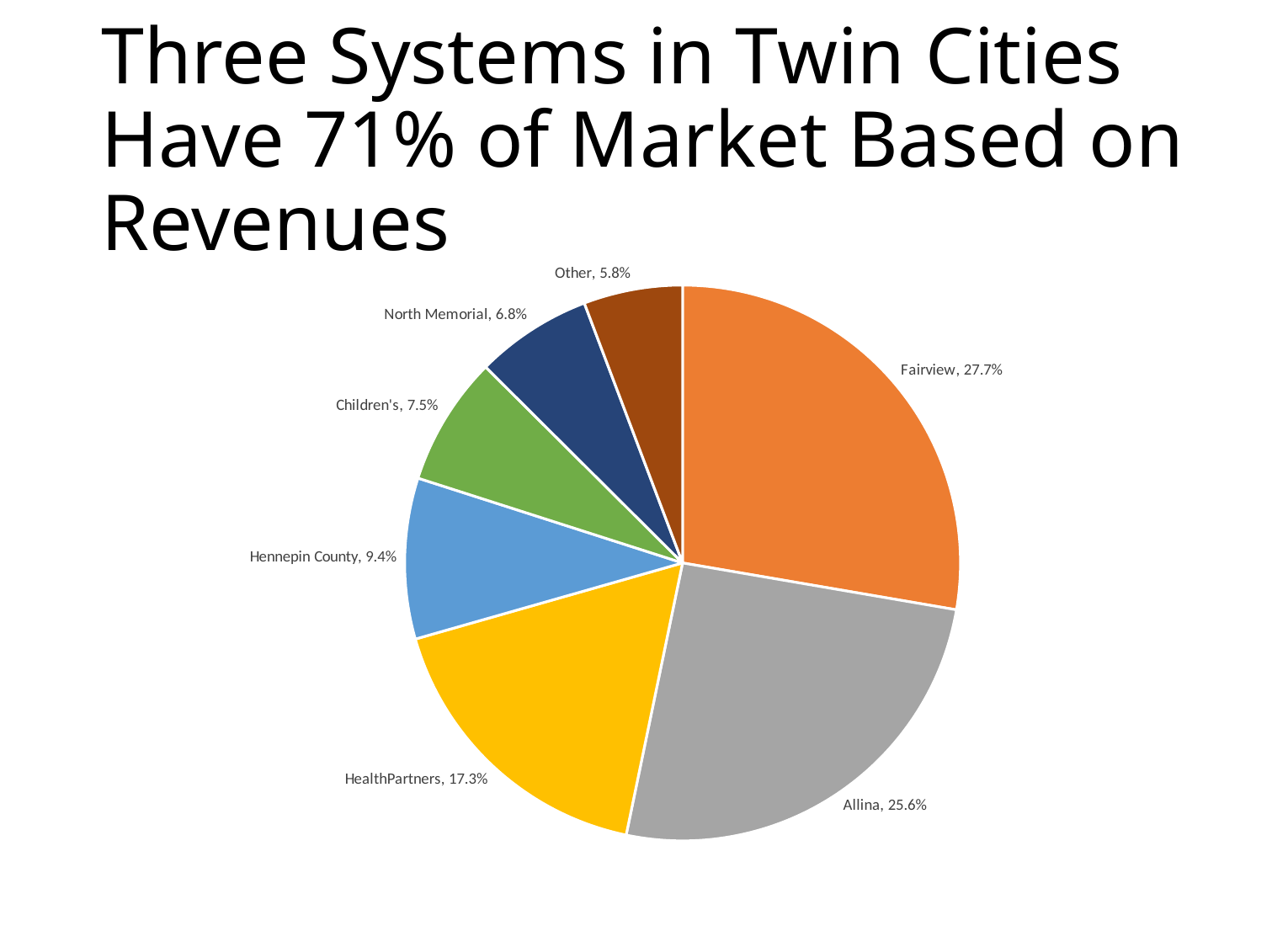
Which slice of the pie is the smallest? Other What is the difference between Fairview's share and Allina's share? 2.1% What is the combined share of Fairview, Allina and HealthPartners? 70.6% What colour is the Allina slice? gray Which has a larger share, Children's or Hennepin County? Hennepin County Which system has the largest share of the market? Fairview What share of the market does HealthPartners have? 17.3% What kind of chart is shown on the slide? pie chart What share of the market does Fairview have? 27.7% What share of the market does Hennepin County have? 9.4% How many slices does the pie chart have? 7 What share of the market does North Memorial have? 6.8%